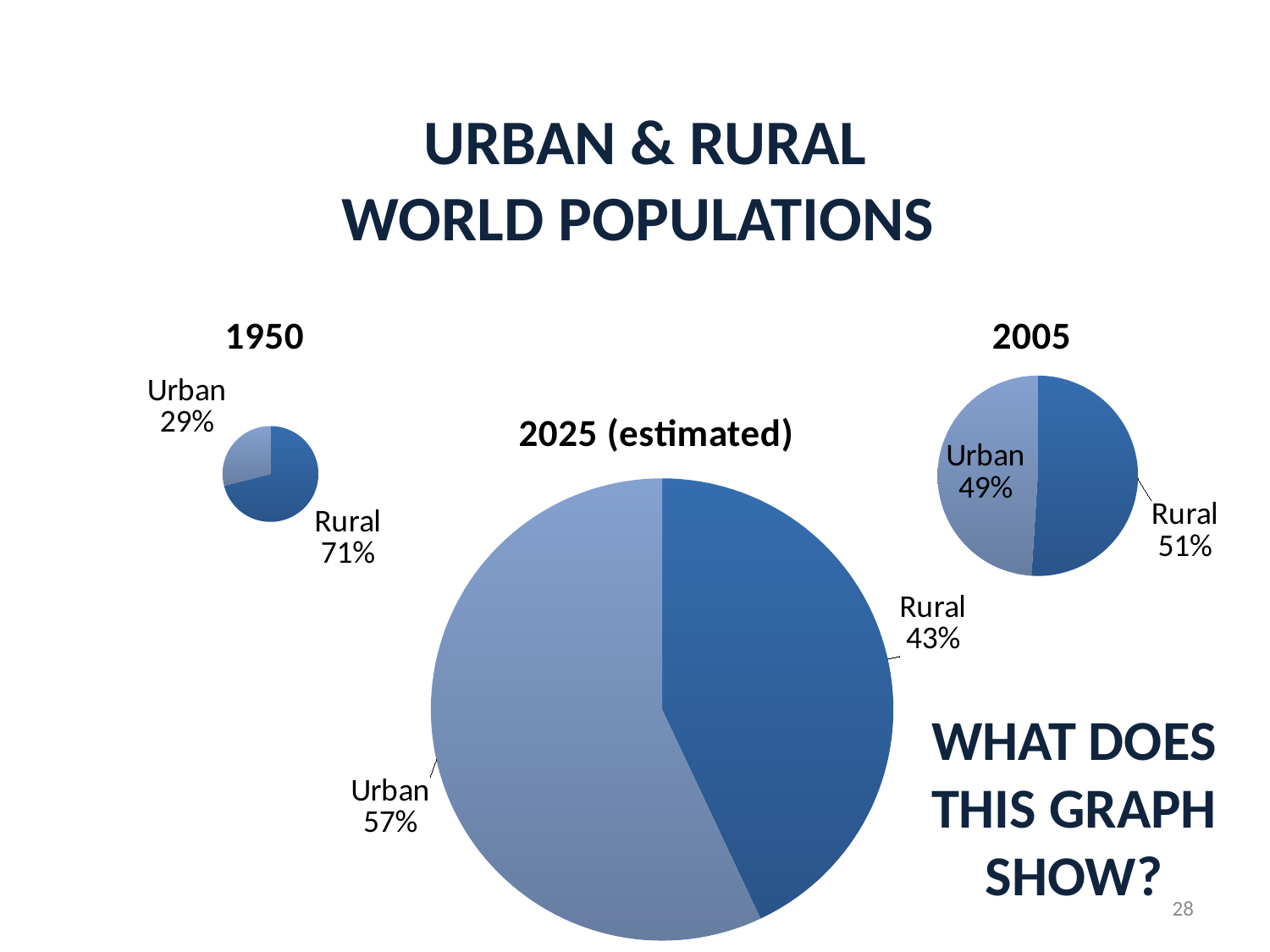
How many pie charts are shown on the slide? 3 In the 2025 (estimated) chart, which slice is the smallest? Rural What kind of chart is the 2025 (estimated) chart? Pie chart In the 2025 (estimated) chart, what share of the world population is Urban? 57% In the 2005 chart, what share of the world population is Urban? 49% In the 1950 chart, which slice is the largest? Rural In the 1950 chart, what share of the world population is Rural? 71% In the 2005 chart, what share of the world population is Rural? 51% In the 1950 chart, what share of the world population is Urban? 29% In the 2025 (estimated) chart, what is the difference between the Urban and Rural shares? 14% In the 1950 chart, which is larger, the Urban share or the Rural share? Rural In the 2025 (estimated) chart, what share of the world population is Rural? 43%